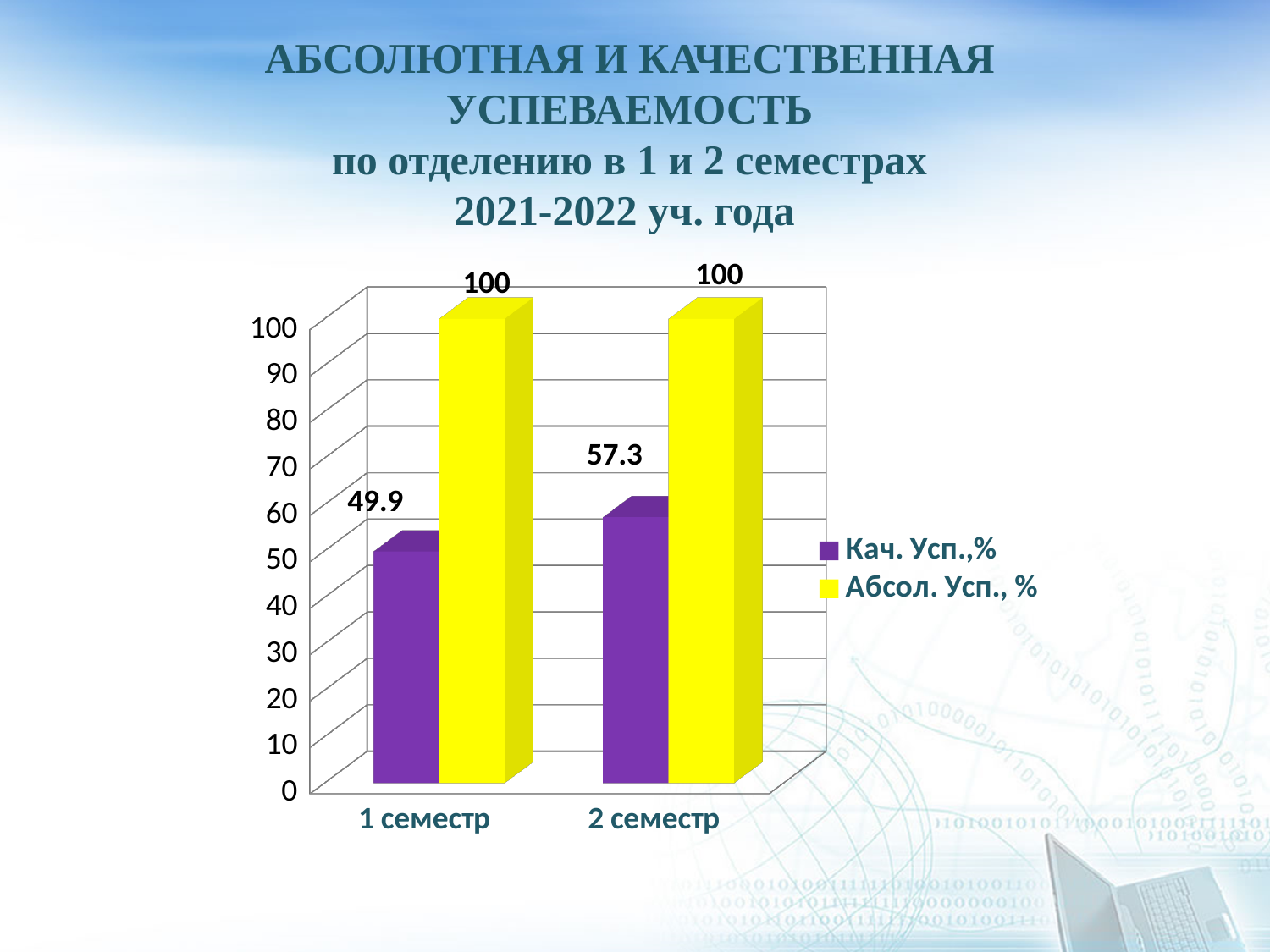
What is the value of Абсол. Усп., % for 2 семестр? 100 Is the value of Кач. Усп.,% for 2 семестр greater or less than 50? greater What kind of chart is shown on the slide? Bar chart What is the difference between the Кач. Усп.,% values for 2 семестр and 1 семестр? 7.4 Which semester has the lower value for Кач. Усп.,%? 1 семестр What is the value of Кач. Усп.,% for 2 семестр? 57.3 What is the value of Абсол. Усп., % for 1 семестр? 100 How many categories are shown on the x axis? 2 Which semester has the higher value for Кач. Усп.,%? 2 семестр What is the value of Кач. Усп.,% for 1 семестр? 49.9 Which is larger for 1 семестр: Кач. Усп.,% or Абсол. Усп., %? Абсол. Усп., % How many series does the legend list? 2